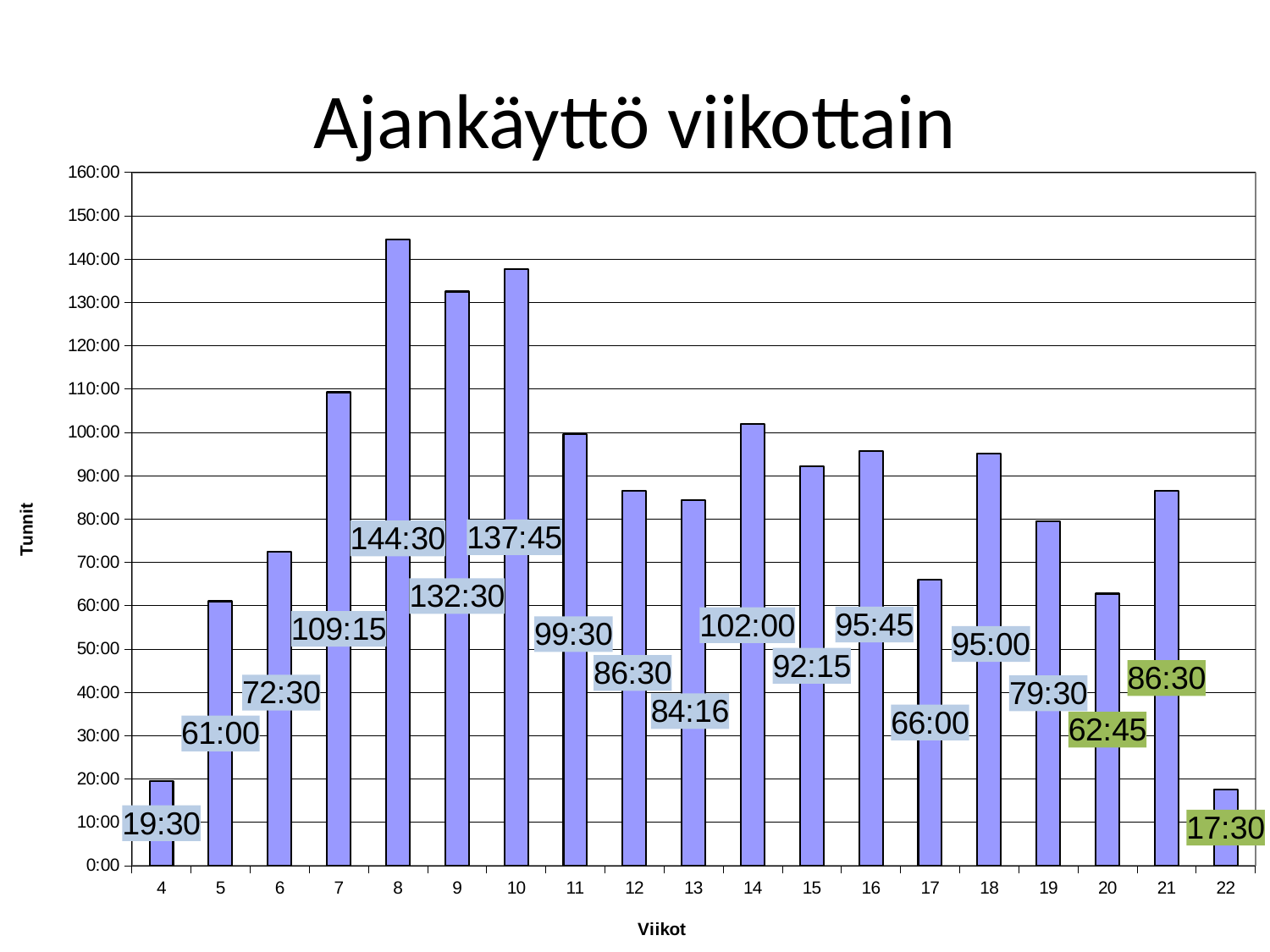
Is the value for week 7 greater or less than 100:00? greater How many weeks are shown on the x axis? 19 What is the difference between the values for week 6 and week 5? 11:30 What kind of chart is shown on the slide? bar chart What is the value for week 8? 144:30 Which week has the highest value? 8 Which week has the lowest value? 22 What is the value for week 20? 62:45 What is the title of the chart? Ajankäyttö viikottain What is the difference between the values for week 8 and week 10? 6:45 What is the value for week 13? 84:16 Which is larger, the value for week 14 or the value for week 15? week 14